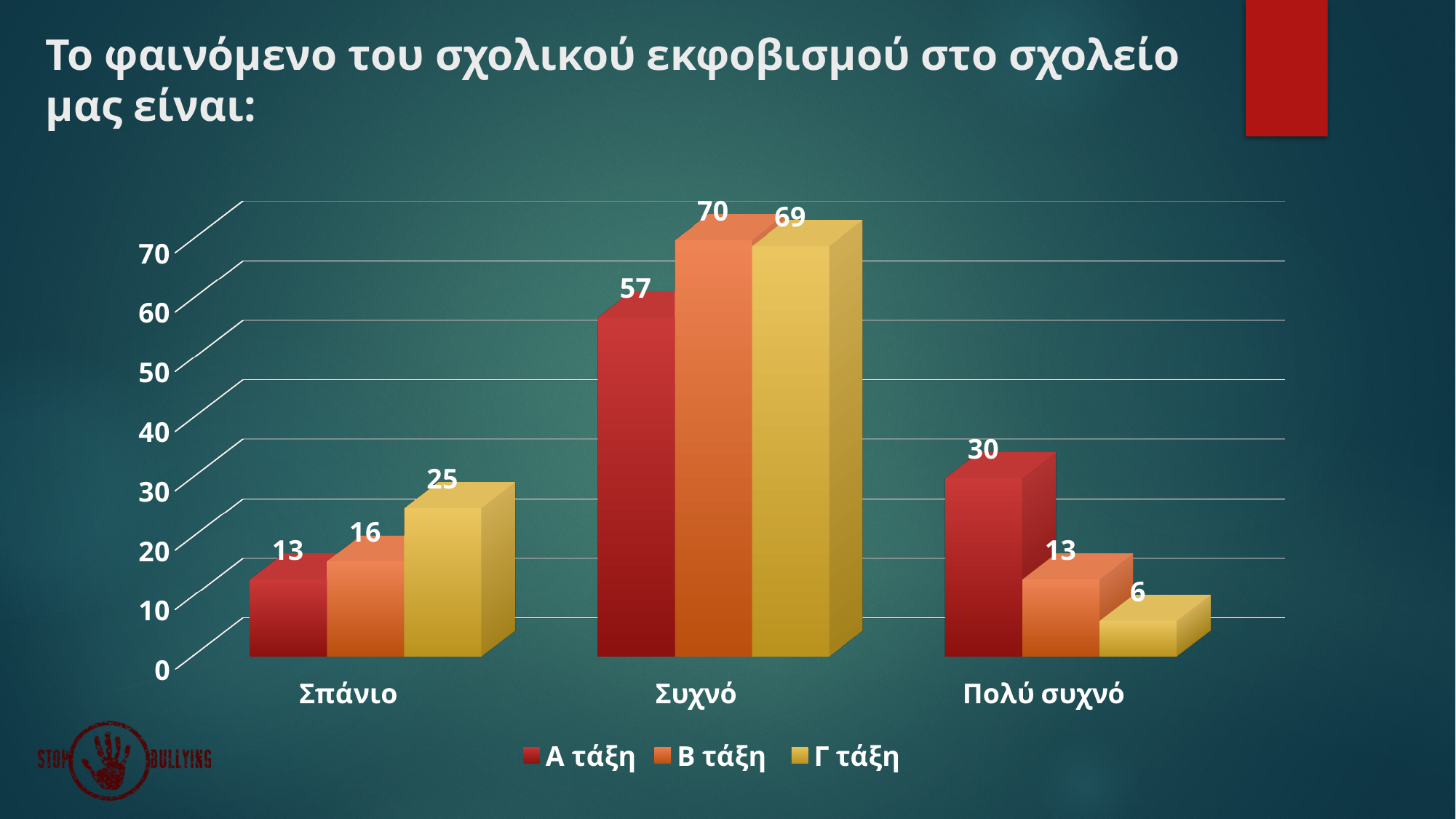
Is the value for Α τάξη in the Πολύ συχνό category greater or less than 20? greater How many series does the legend list? 3 What is the difference between the Β τάξη and Α τάξη values in the Συχνό category? 13 In the Πολύ συχνό category, which series has the larger value, Α τάξη or Γ τάξη? Α τάξη What is the value for Β τάξη in the Πολύ συχνό category? 13 What is the value for Γ τάξη in the Σπάνιο category? 25 Which category has the lowest value for Γ τάξη? Πολύ συχνό How many categories are shown on the x axis? 3 Which series is shown in yellow in the legend? Γ τάξη What is the value for Α τάξη in the Συχνό category? 57 Which category has the highest value for Β τάξη? Συχνό What kind of chart is shown on the slide? Bar chart